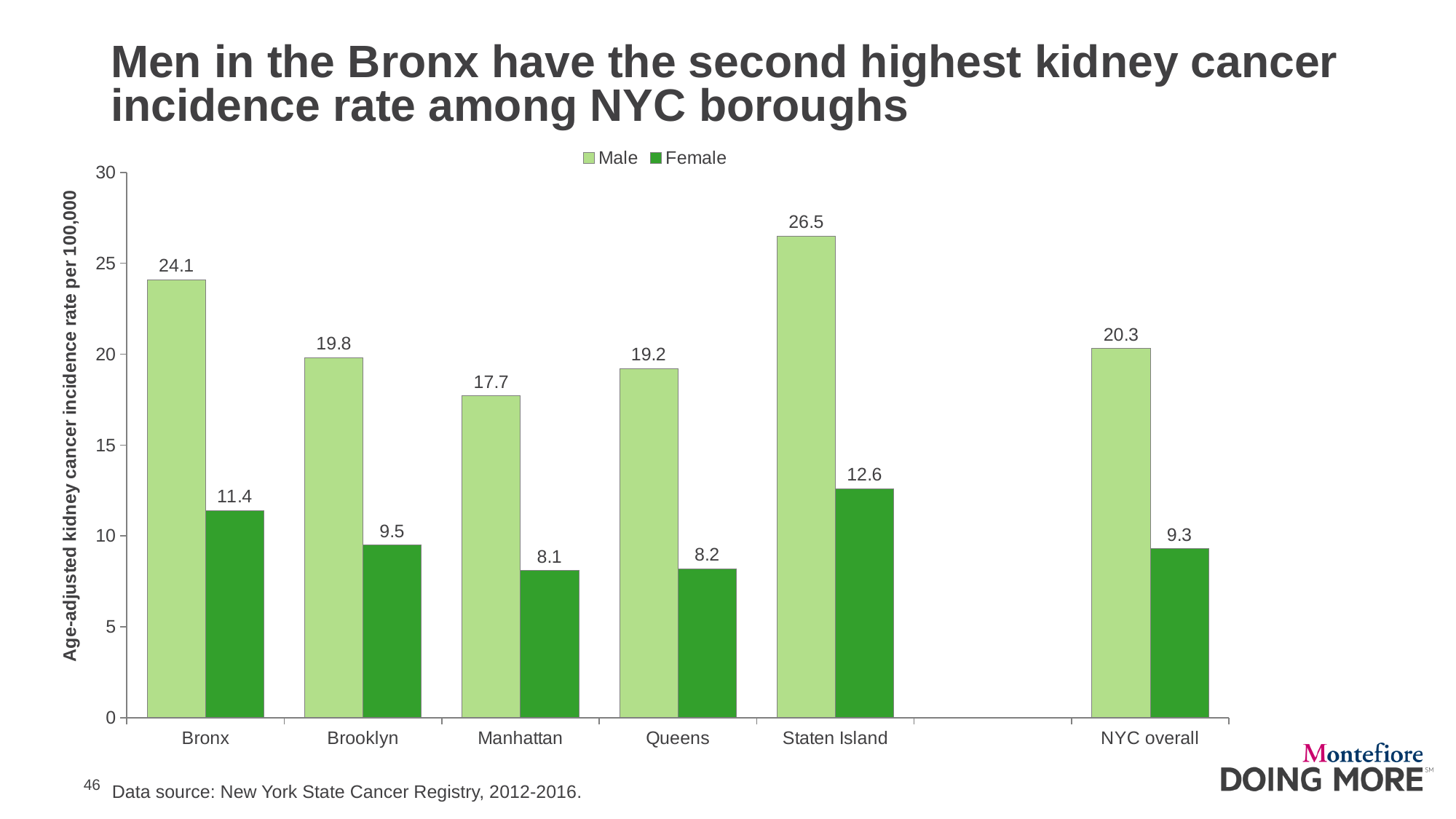
What is the label of the y axis? Age-adjusted kidney cancer incidence rate per 100,000 Which is larger, the Male rate for Brooklyn or the Male rate for Queens? Brooklyn What kind of chart is shown on the slide? bar chart How many series does the legend list? 2 What is the difference between the Male and Female rates for the Bronx? 12.7 What is the Female kidney cancer incidence rate for Staten Island? 12.6 What is the Male value for NYC overall? 20.3 Which category has the highest Male incidence rate? Staten Island How many categories are shown on the x axis? 6 Which category has the lowest Female incidence rate? Manhattan What is the Male kidney cancer incidence rate for the Bronx? 24.1 Is the Male value for Manhattan greater or less than 20? less